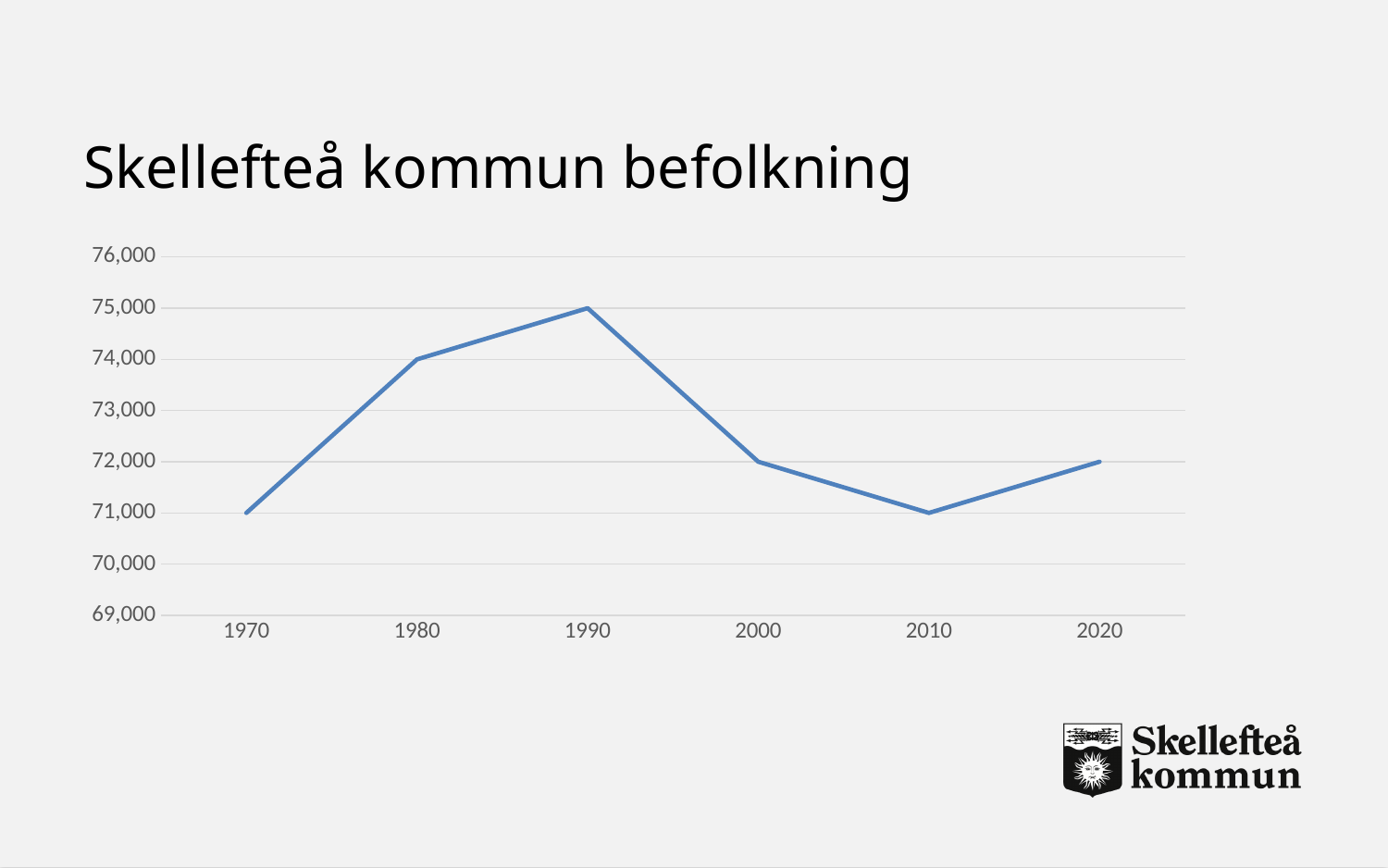
What is the population value for 2000? 72,000 Which year has the highest population value? 1990 What is the difference between the population values for 1970 and 1980? 3,000 What is the difference between the population values for 1990 and 2010? 4,000 What is the population value for 1980? 74,000 How many years are plotted on the x axis? 6 Is the population value for 2020 greater or less than 73,000? less What is the population value for 1990? 75,000 What kind of chart is shown on the slide? line chart What is the title of the chart? Skellefteå kommun befolkning Which is larger, the population value for 1980 or for 2000? 1980 Does the population rise or fall between 1990 and 2010? fall